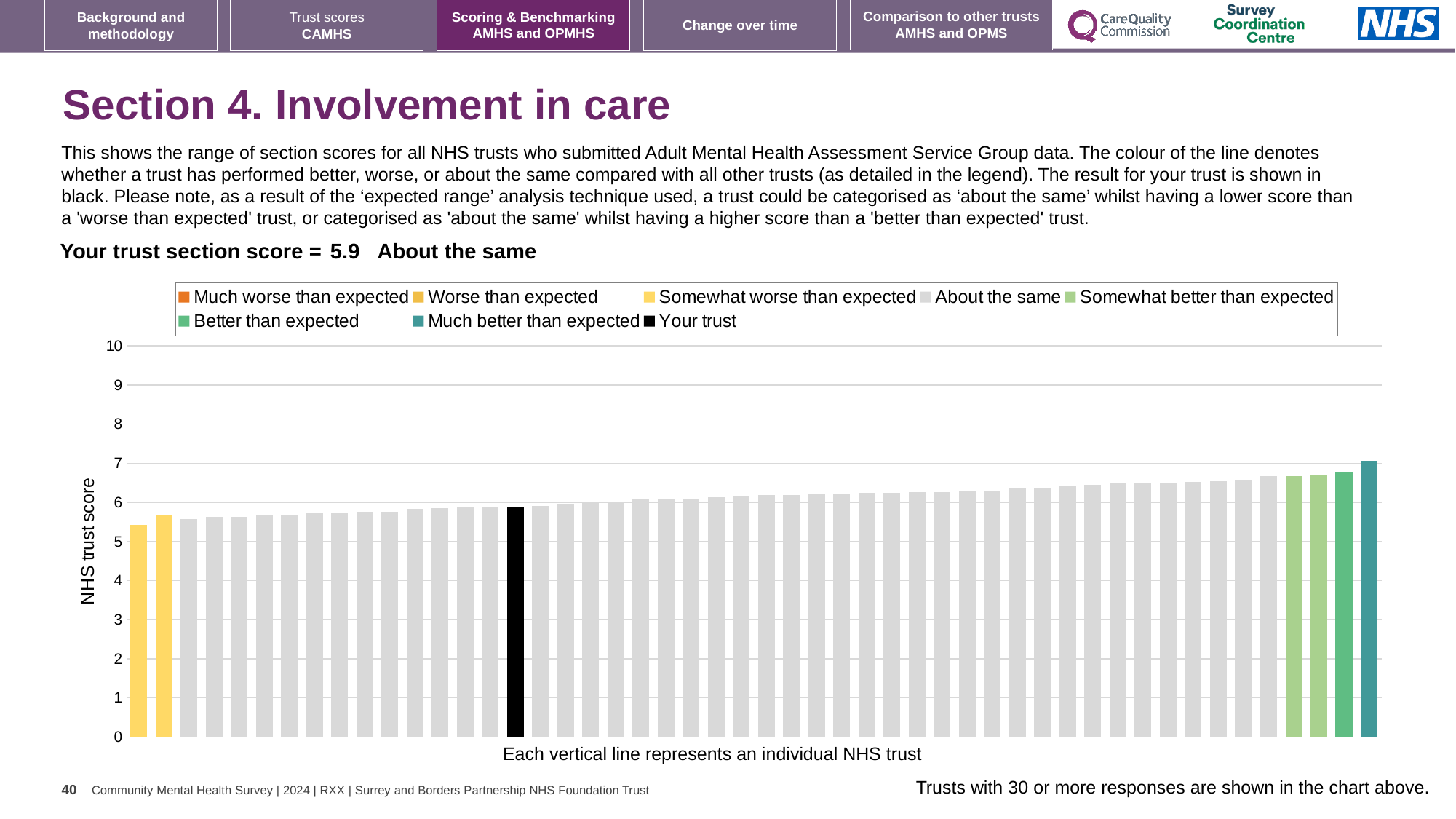
What is the section score for your trust, as printed on the slide? 5.9 Which legend category does the tallest bar belong to? Much better than expected Is the value of the leftmost (lowest) bar greater or less than 6? less Is the value of the black 'Your trust' bar greater or less than 5? greater How many bars are coloured as 'Much better than expected' (teal)? 1 Which category is your trust placed in for this section? About the same How many bars are coloured as 'Worse than expected' (yellow)? 0 Is the value of the rightmost (highest) bar greater or less than 6? greater What kind of chart is shown on the slide? bar chart Do the bar values rise or fall from left to right along the x axis? rise How many entries does the chart legend list? 8 What is the label on the y axis of the chart? NHS trust score